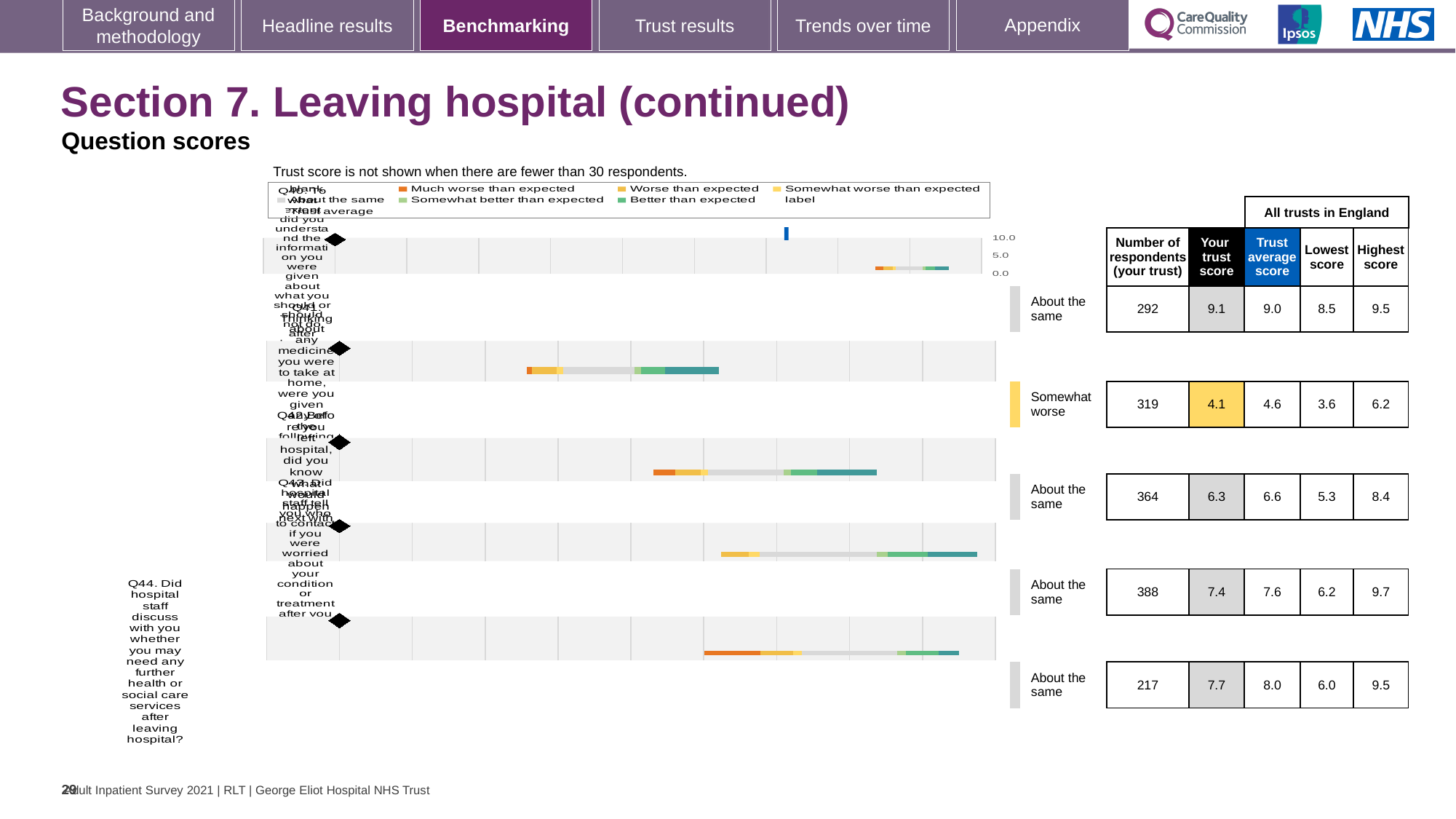
How is this trust's result for Q44 rated compared with expectations? About the same What is the highest score among all trusts in England for Q44? 9.5 How many respondents answered Q44 at this trust? 217 What is the difference between the trust average score and this trust's score for Q44? 0.3 What is this trust's score for the question rated 'Somewhat worse'? 4.1 How many questions are rated 'Somewhat worse' on this slide? 1 For Q44, which is larger: this trust's score or the trust average score? Trust average score What is the lowest score among all trusts in England for Q44? 6.0 What is the trust score for Q44 (Did hospital staff discuss with you whether you may need any further health or social care services after leaving hospital?)? 7.7 What is the trust average score across all trusts in England for Q44? 8.0 What kind of chart is used to show the question scores on this slide? Bar chart What is the highest 'Your trust score' shown in the table on this slide? 9.1